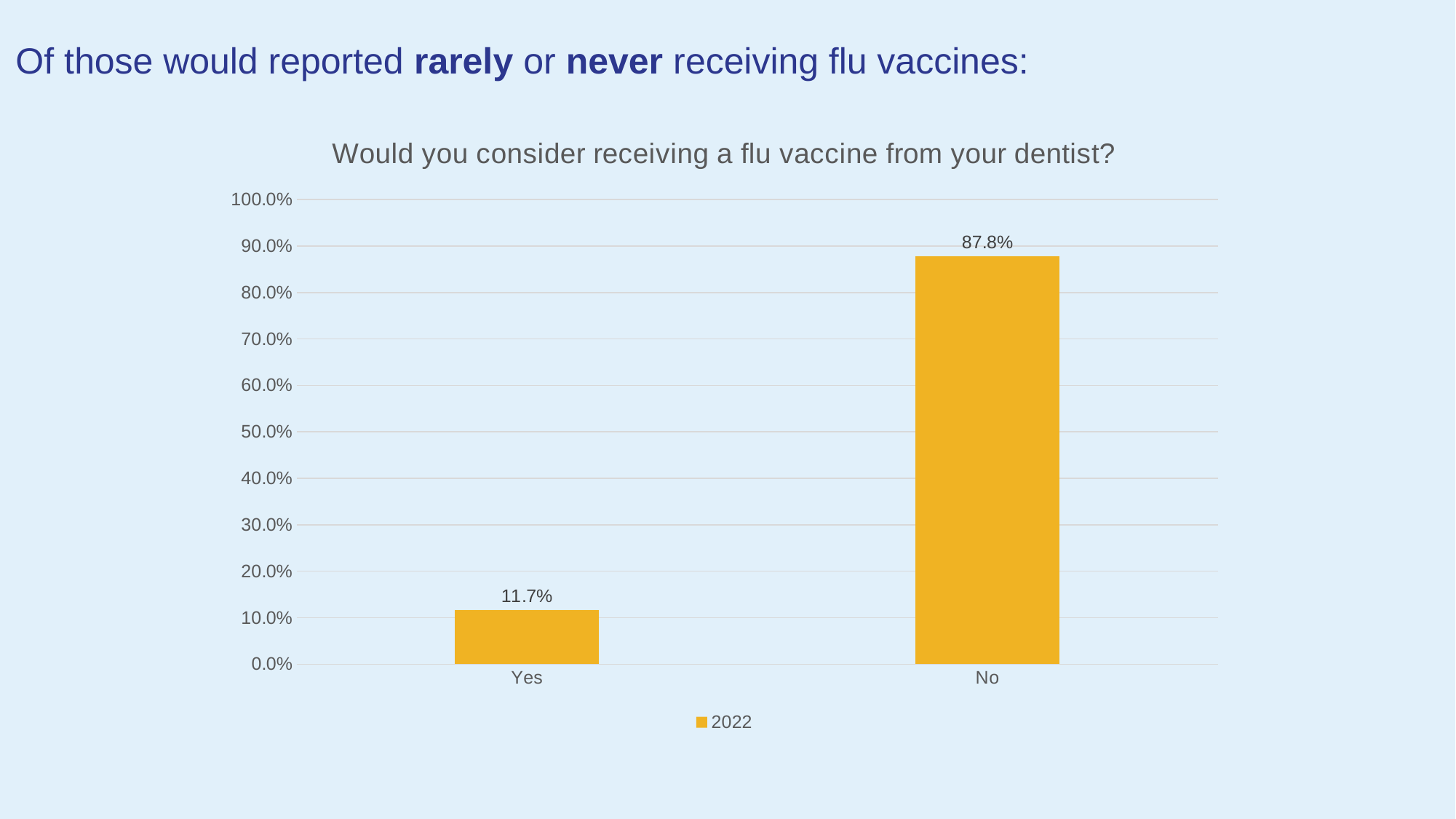
What is the difference between the values for "No" and "Yes"? 76.1% Is the value for "Yes" greater or less than 20.0%? less Which category has the lowest value? Yes What is the title of the chart? Would you consider receiving a flu vaccine from your dentist? How many categories are shown on the x axis? 2 What is the value for "Yes"? 11.7% How many series does the legend list? 1 Is the value for "No" greater or less than 80.0%? greater What is the value for "No"? 87.8% Which category has the highest value? No Which is larger, the value for "Yes" or the value for "No"? No What kind of chart is shown? bar chart